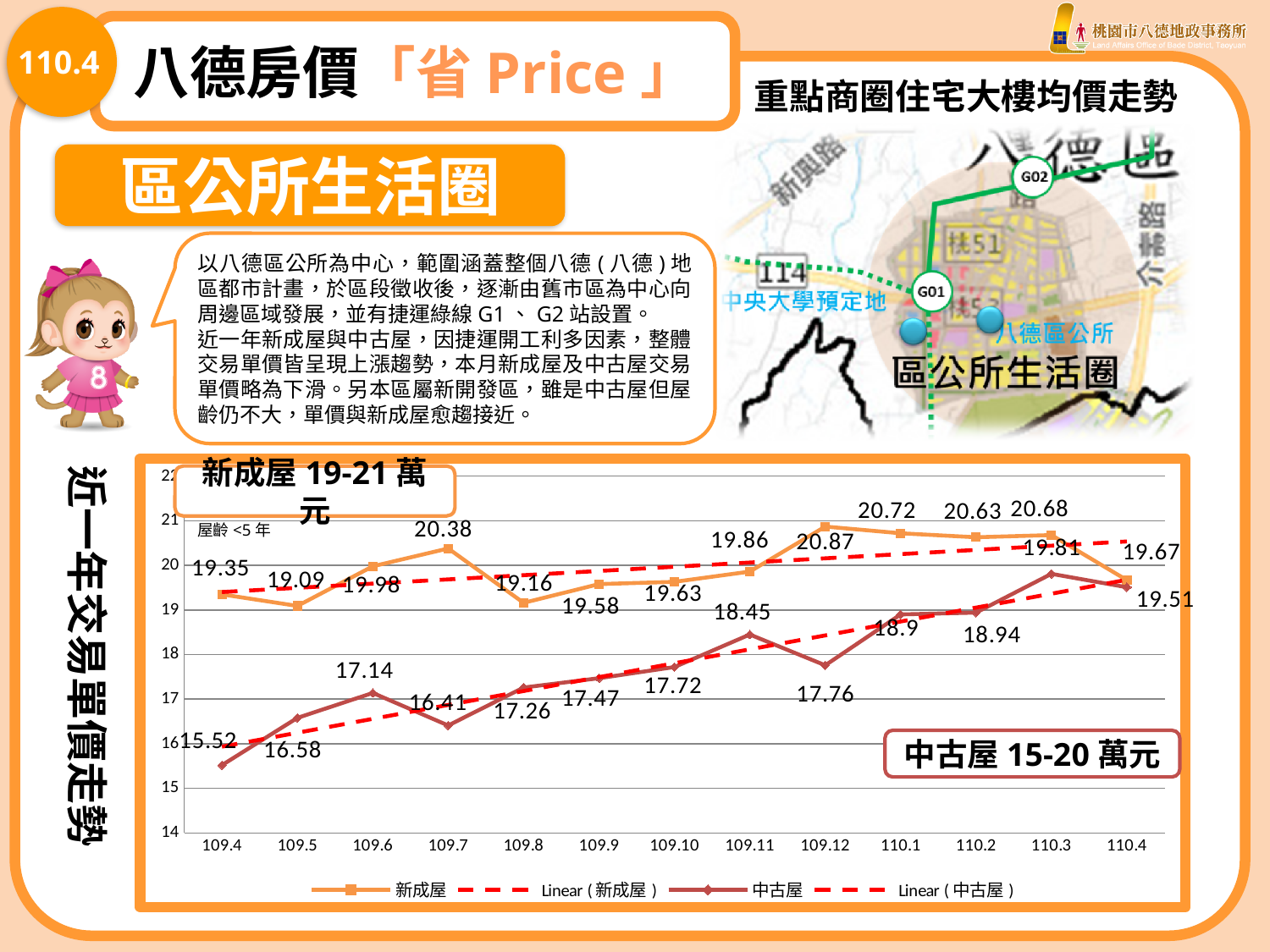
What is the difference between the 新成屋 and 中古屋 values at 109.4? 3.83 At which time point does 新成屋 reach its highest value? 109.12 Which is larger at 109.12: the 新成屋 value or the 中古屋 value? 新成屋 What is the value for 新成屋 at 110.4? 19.67 What is the value for 新成屋 at 109.4? 19.35 What is the value for 中古屋 at 109.4? 15.52 How many time points are plotted along the x axis of the chart? 13 How many series does the chart legend list? 4 At which time point is the 中古屋 value lowest? 109.4 What type of chart is shown on the slide? line chart What is the value for 中古屋 at 110.3? 19.81 Does the 中古屋 series generally rise or fall from 109.4 to 110.4? rise